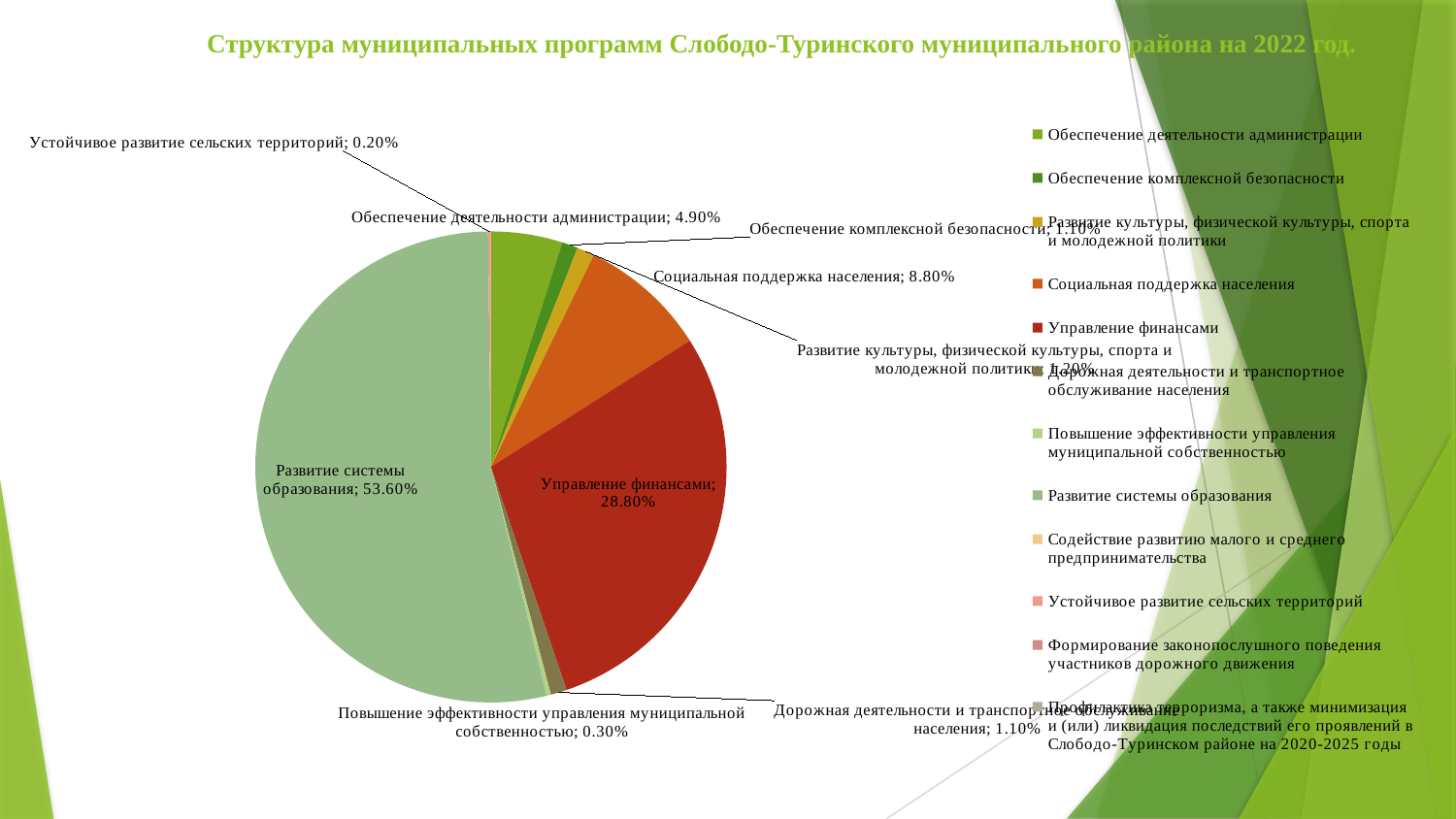
What share of the pie does "Развитие системы образования" have? 53.60% What is the difference in percentage points between "Развитие системы образования" and "Управление финансами"? 24.80% What is the value shown for "Социальная поддержка населения"? 8.80% Which is larger: "Социальная поддержка населения" or "Обеспечение деятельности администрации"? Социальная поддержка населения What share of the pie does "Управление финансами" have? 28.80% Which category has the largest share of the pie? Развитие системы образования What is the value shown for "Повышение эффективности управления муниципальной собственностью"? 0.30% What kind of chart is shown on the slide? Pie chart What is the title of the chart? Структура муниципальных программ Слободо-Туринского муниципального района на 2022 год. How many entries does the legend list? 12 What is the value shown for "Обеспечение деятельности администрации"? 4.90% Which labelled category has the smallest share of the pie? Устойчивое развитие сельских территорий